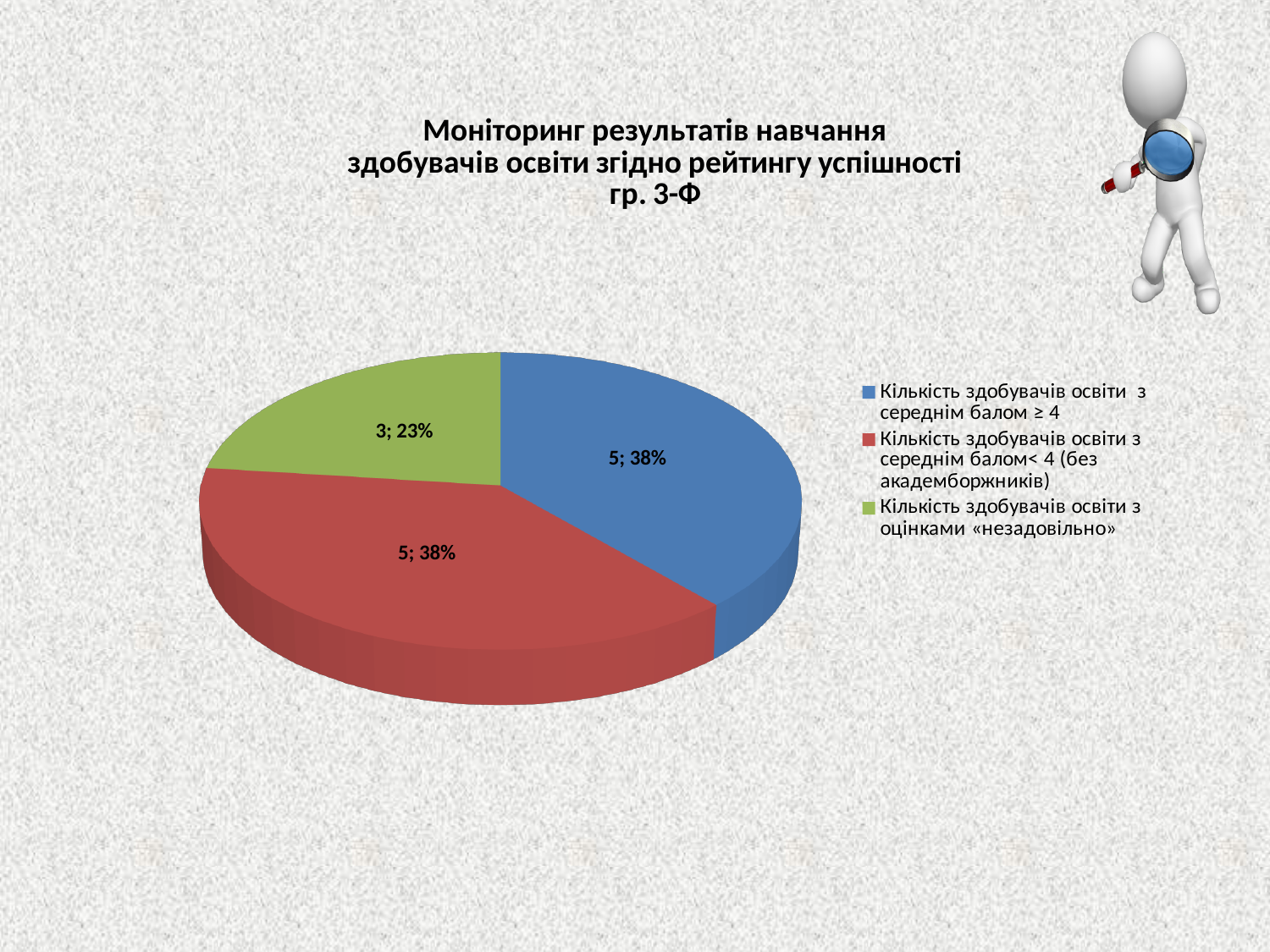
What is the value for "Кількість здобувачів освіти з оцінками «незадовільно»"? 3 Which colour represents "Кількість здобувачів освіти з оцінками «незадовільно»" in the pie chart? green What share of the pie does "Кількість здобувачів освіти з середнім балом< 4 (без академборжників)" take? 38% How many slices does the pie chart have? 3 What share of the pie does "Кількість здобувачів освіти з оцінками «незадовільно»" take? 23% How many entries does the legend list? 3 What kind of chart is shown on the slide? pie chart What is the difference between the value for "Кількість здобувачів освіти з середнім балом ≥ 4" and the value for "Кількість здобувачів освіти з оцінками «незадовільно»"? 2 What is the total of all three slice values? 13 Which is larger: the value for "Кількість здобувачів освіти з середнім балом ≥ 4" or for "Кількість здобувачів освіти з оцінками «незадовільно»"? Кількість здобувачів освіти з середнім балом ≥ 4 Which category has the smallest slice? Кількість здобувачів освіти з оцінками «незадовільно» What is the value for "Кількість здобувачів освіти з середнім балом ≥ 4"? 5